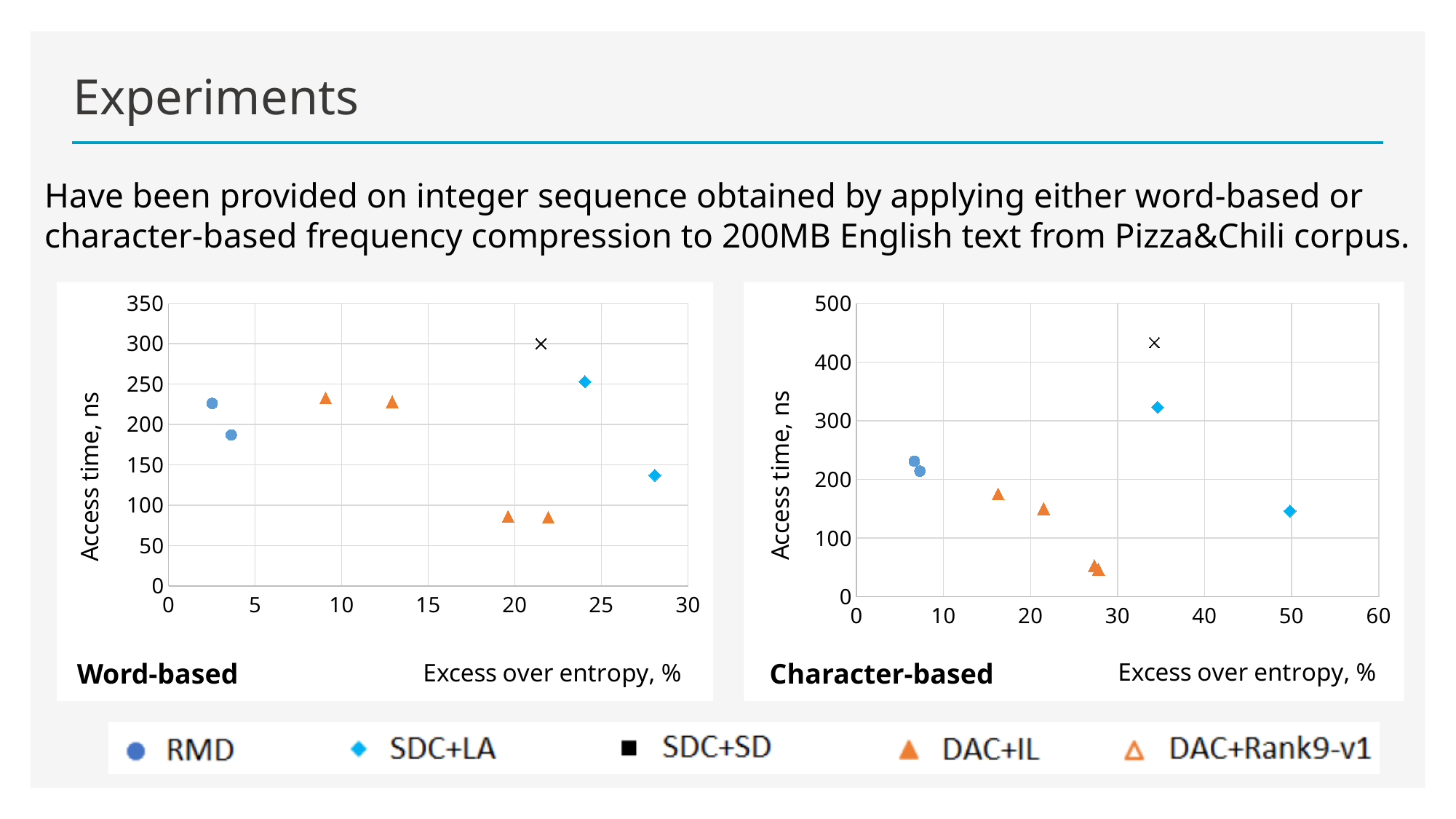
What is the x-axis label of the Word-based chart? Excess over entropy, % What is the y-axis label of the Character-based chart? Access time, ns In the Word-based chart, how many RMD points are plotted? 2 In the Character-based chart, is the lowest DAC+IL access time greater or less than 100? less In the Character-based chart, do the DAC+IL access times rise or fall as excess over entropy increases? fall How many series does the legend list? 5 In the Character-based chart, is the access time of the SDC+LA point near 50% excess over entropy greater or less than 200? less In the Word-based chart, which series reaches a lower access time, RMD or DAC+IL? DAC+IL In the Word-based chart, are both RMD points' access times greater or less than 150? greater What kind of chart is the Word-based chart? scatter chart